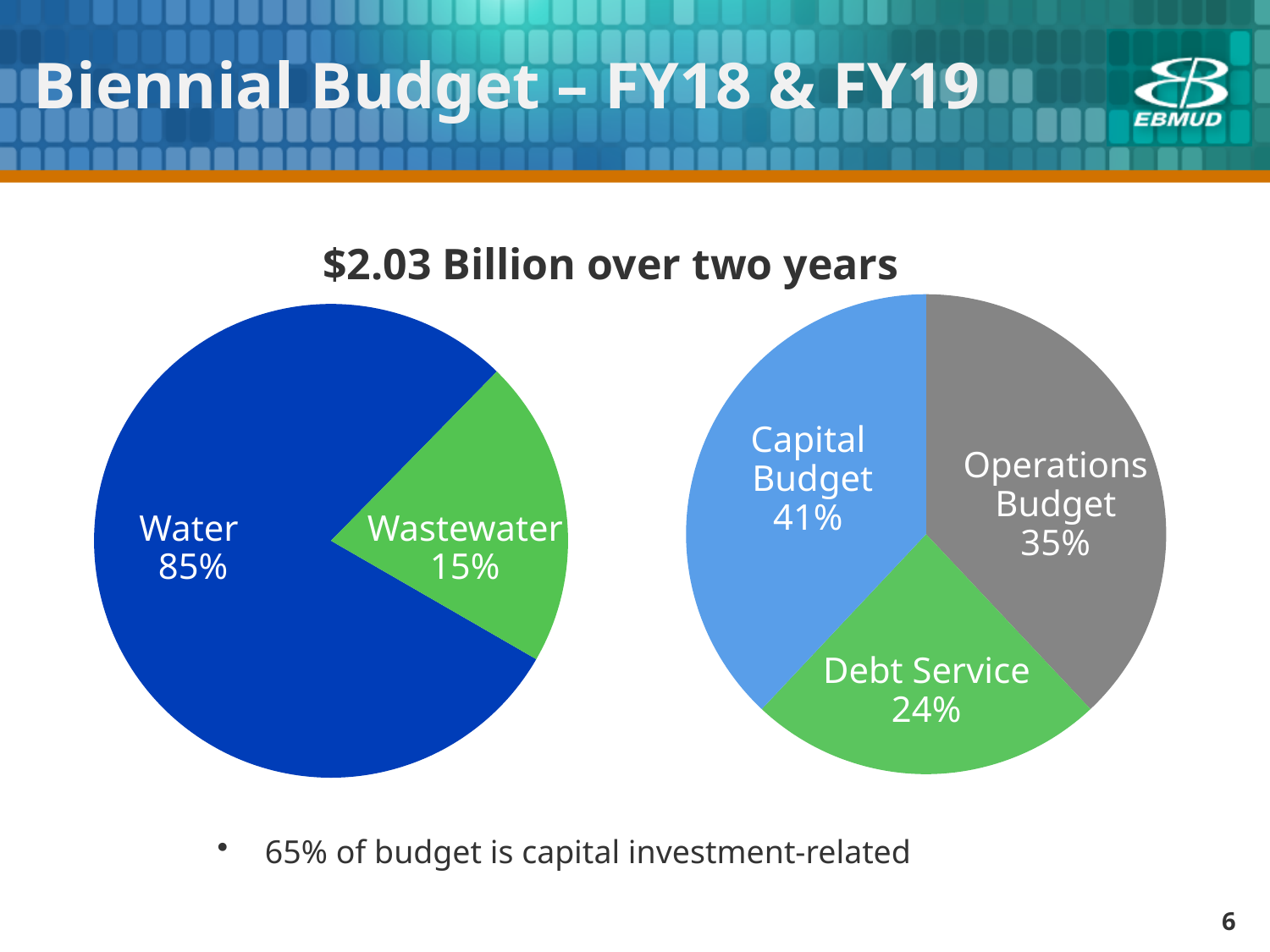
In the right pie chart, what share is Debt Service? 24% In the right pie chart, what share is the Capital Budget? 41% In the left pie chart, what share of the budget is Wastewater? 15% How many slices does the right pie chart have? 3 What type of chart is the left chart on the slide? Pie chart In the right pie chart, what share is the Operations Budget? 35% In the right pie chart, what is the difference in percentage points between Capital Budget and Operations Budget? 6 percentage points In the right pie chart, which slice is the smallest? Debt Service In the left pie chart, what is the difference in percentage points between Water and Wastewater? 70 percentage points In the right pie chart, which is larger, Operations Budget or Debt Service? Operations Budget In the right pie chart, which slice is the largest? Capital Budget In the left pie chart, what share of the budget is Water? 85%